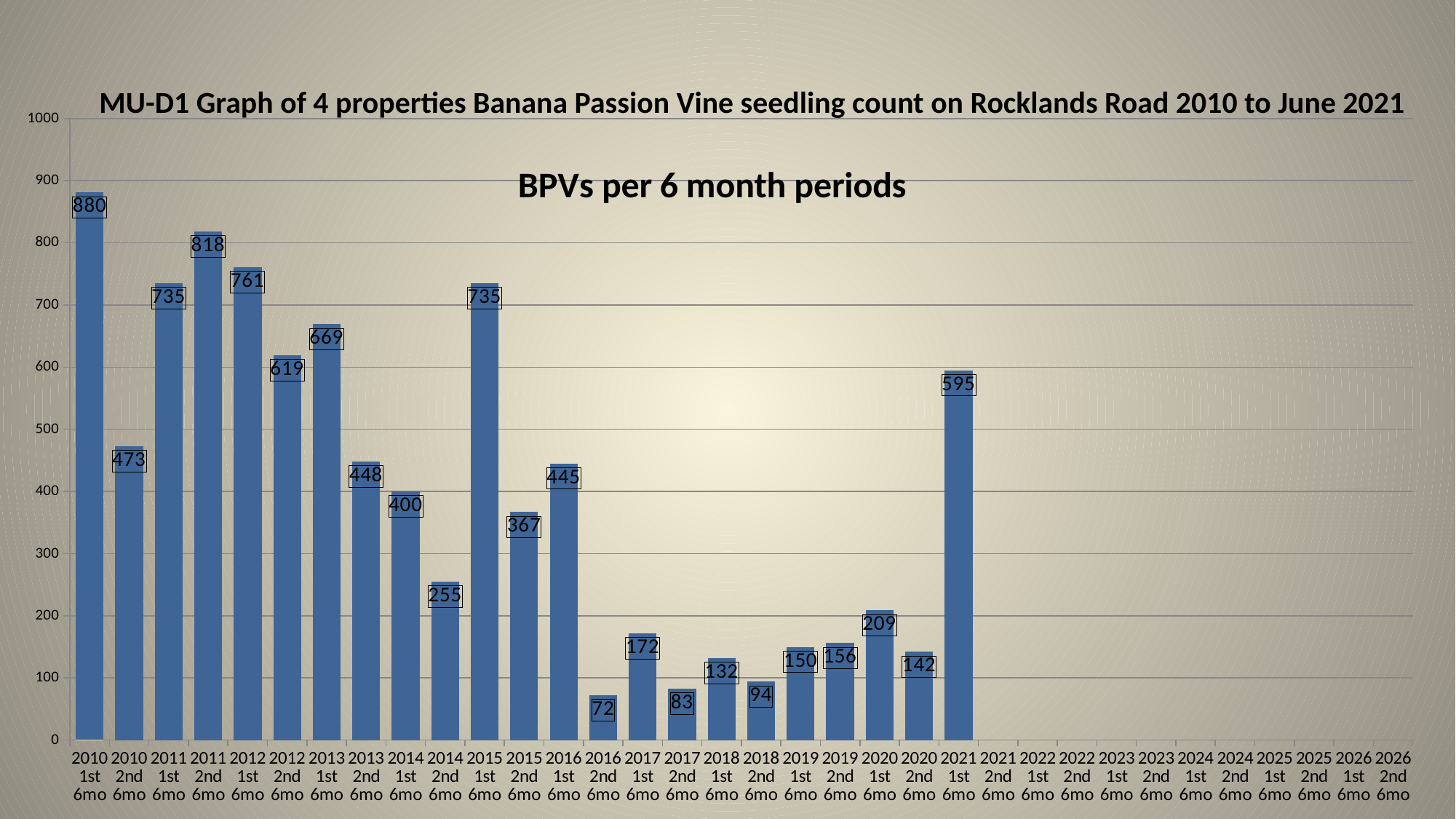
Which period has a higher BPV count, 2012 1st 6mo or 2013 1st 6mo? 2012 1st 6mo What is the BPV count for the 2021 1st 6mo period? 595 What kind of chart is shown on the slide? Bar chart Which 6 month period has the highest BPV count? 2010 1st 6mo What is the BPV count for the 2010 1st 6mo period? 880 How many 6 month periods have a plotted bar with a data label? 23 What is the difference between the BPV counts for 2021 1st 6mo and 2020 2nd 6mo? 453 Do the BPV counts generally rise or fall from 2010 1st 6mo to 2016 2nd 6mo? Fall Which 6 month period has the lowest BPV count? 2016 2nd 6mo What is the difference between the BPV counts for 2010 1st 6mo and 2010 2nd 6mo? 407 What is the BPV count for the 2014 2nd 6mo period? 255 Is the value for 2015 2nd 6mo greater or less than 300? greater